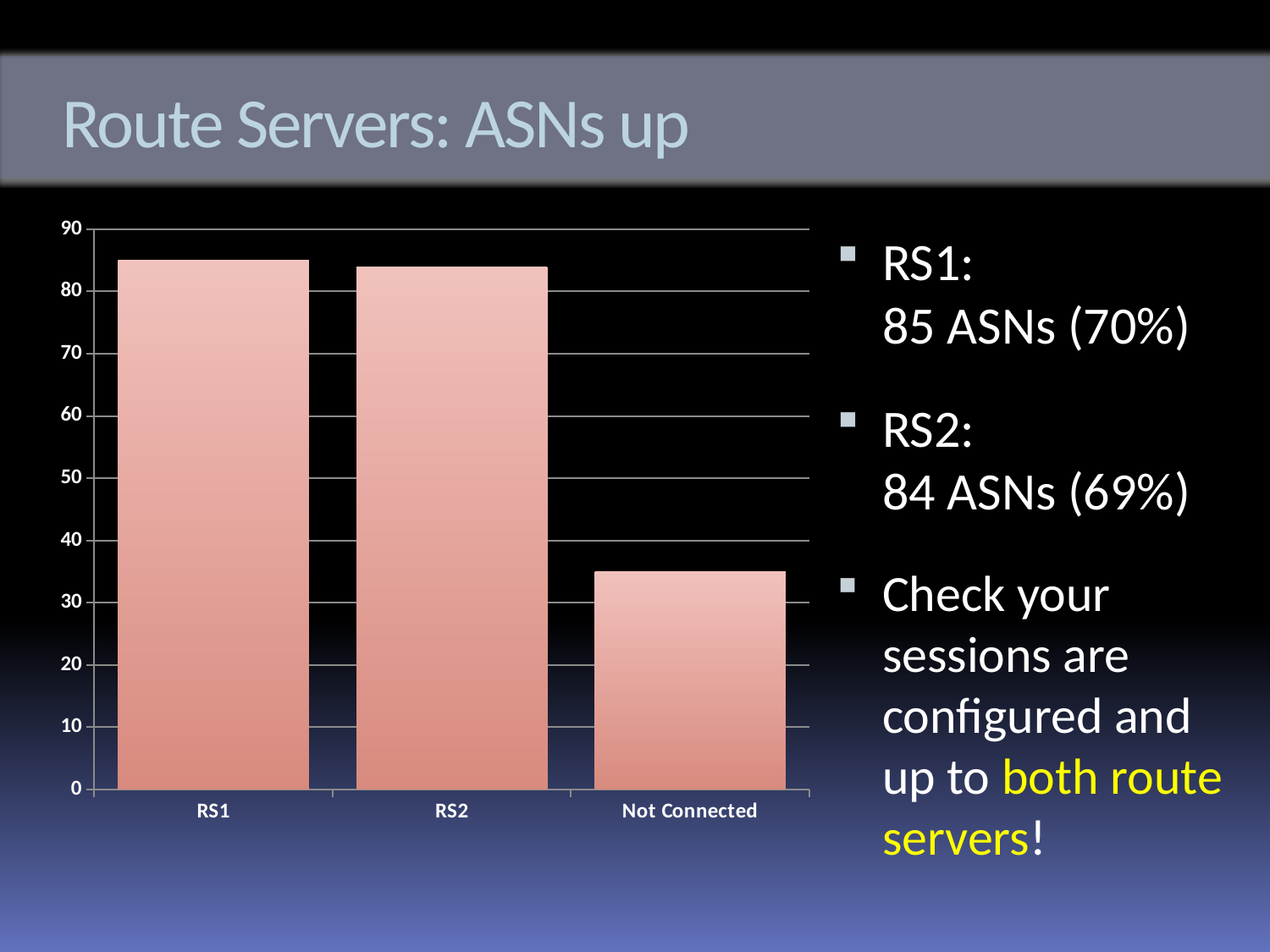
What is the title of the slide containing the chart? Route Servers: ASNs up Is the value for RS1 greater or less than 80? greater What is the difference between the RS1 and RS2 ASN counts given on the slide? 1 Is the value for Not Connected greater or less than 40? less Which category has the lowest bar in the chart? Not Connected What is the highest value shown on the y axis of the chart? 90 How many categories are shown on the x axis of the chart? 3 How many ASNs are up on RS1, according to the slide? 85 What kind of chart is shown on the slide? bar chart Which is larger, the bar for RS2 or the bar for Not Connected? RS2 How many ASNs are up on RS2, according to the slide? 84 Is the value for Not Connected greater or less than 30? greater